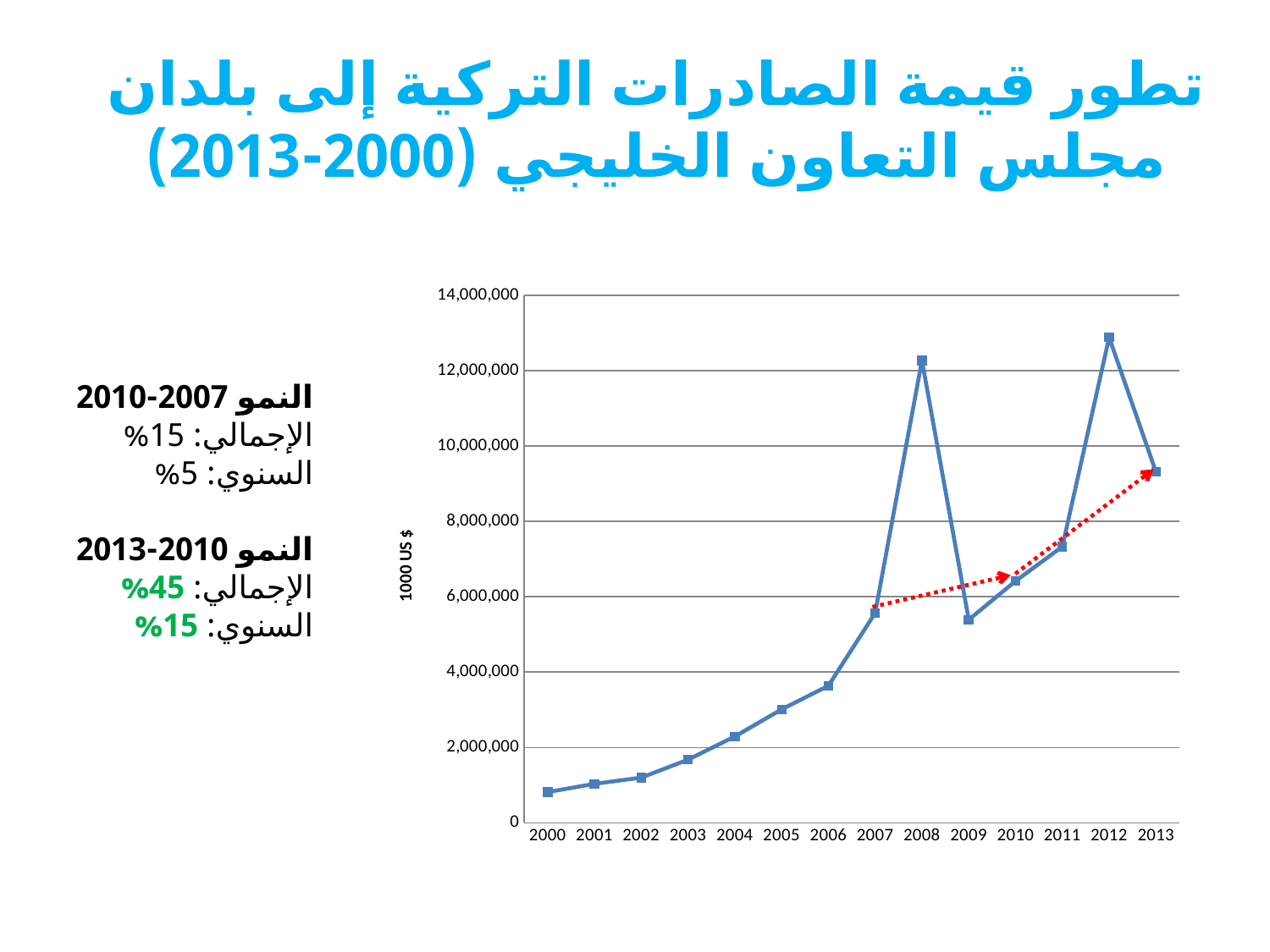
Is the value for 2013 greater or less than 8,000,000? greater What is the label on the vertical axis? 1000 US $ Which year has the lowest value on the chart? 2000 How many years are plotted along the x axis? 14 Which year has the highest value on the chart? 2012 Which year has the larger value, 2008 or 2009? 2008 Do the values rise or fall from 2000 to 2007? rise Is the value for 2003 greater or less than 2,000,000? less Is the value for 2008 greater or less than 12,000,000? greater Which year has the larger value, 2011 or 2013? 2013 What kind of chart is shown on the slide? line chart